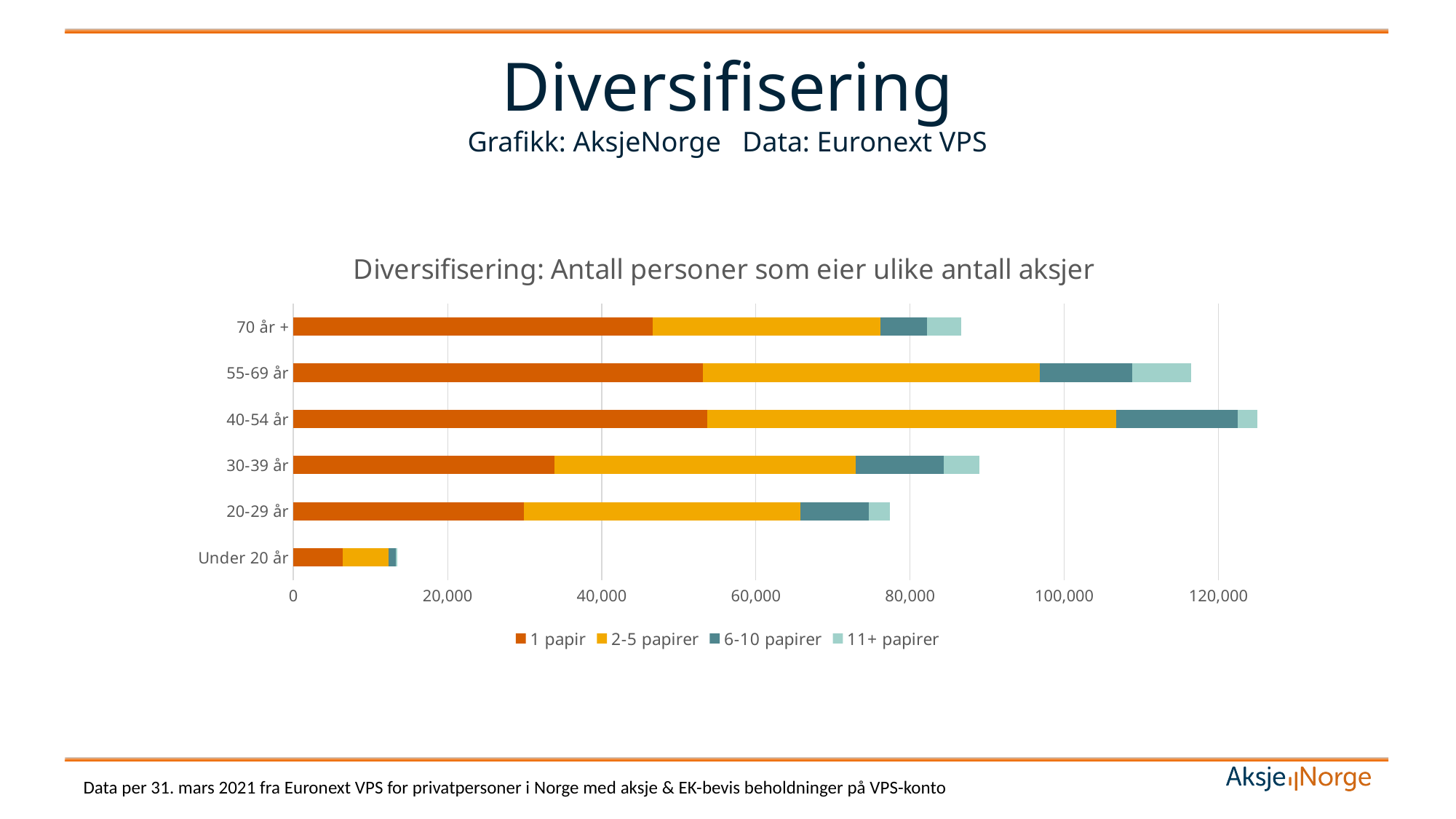
What kind of chart is shown on the slide? bar chart What is the title of the chart? Diversifisering: Antall personer som eier ulike antall aksjer Is the total bar for 40-54 år greater or less than 120,000? greater Which age group has the longest total bar? 40-54 år Is the '1 papir' segment for 70 år + greater or less than 40,000? greater Which age group has the shortest total bar? Under 20 år Which has the longer total bar, 55-69 år or 30-39 år? 55-69 år How many series does the legend list? 4 How many age groups are shown on the chart? 6 Is the total bar for Under 20 år greater or less than 20,000? less Which series is listed first in the legend? 1 papir